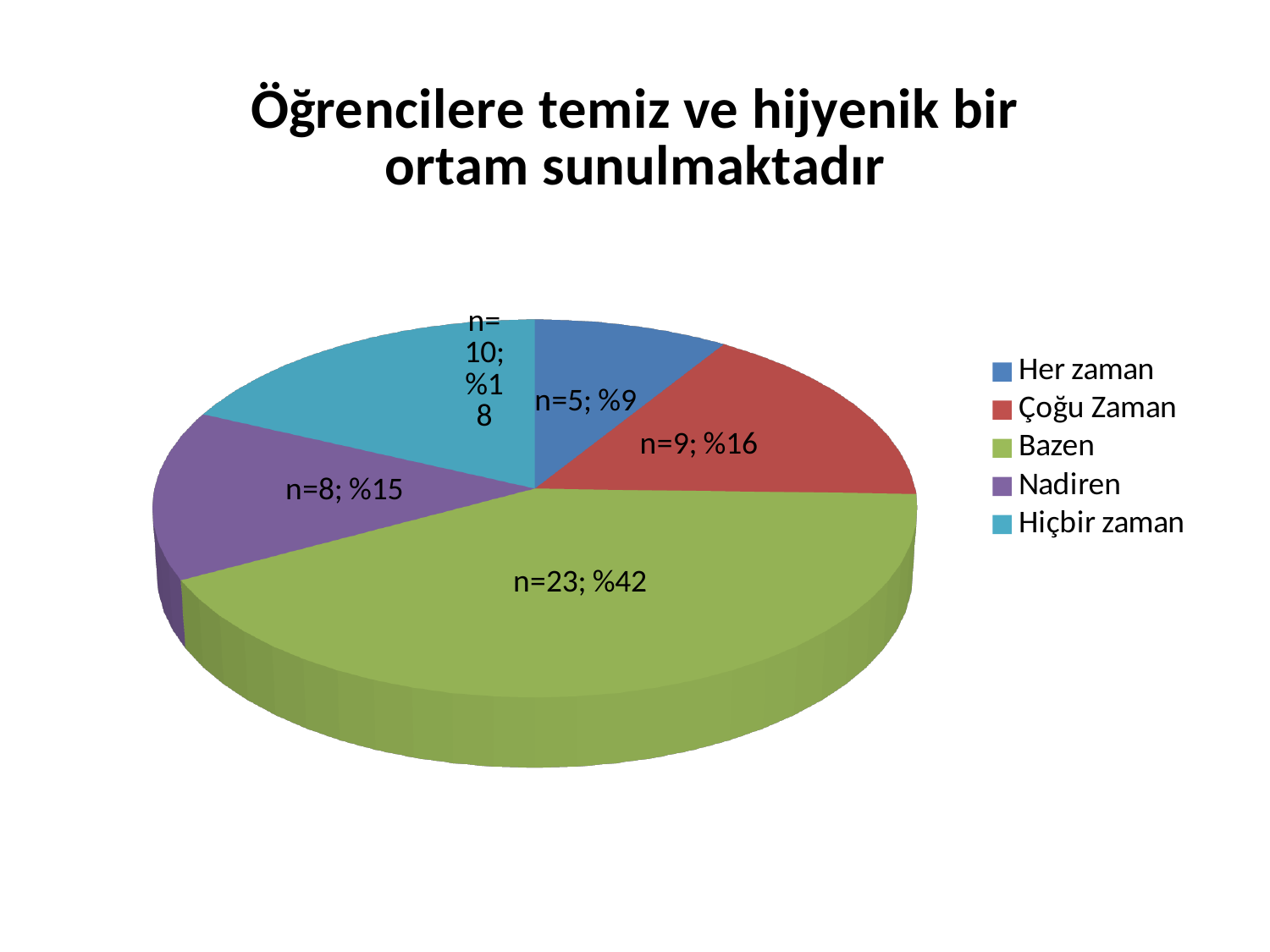
How many categories does the legend list? 5 What percentage share does the Çoğu Zaman slice have? %16 What kind of chart is shown on the slide? pie chart Which category has the smallest slice? Her zaman What is the title of the chart? Öğrencilere temiz ve hijyenik bir ortam sunulmaktadır What is the difference in count between Bazen and Nadiren? 15 What percentage share does the Bazen slice have? %42 What is the count (n) for the Bazen slice? 23 Which category has the largest slice? Bazen What is the count (n) for the Hiçbir zaman slice? 10 Which has a larger count, Çoğu Zaman or Nadiren? Çoğu Zaman What is the count (n) for the Her zaman slice? 5